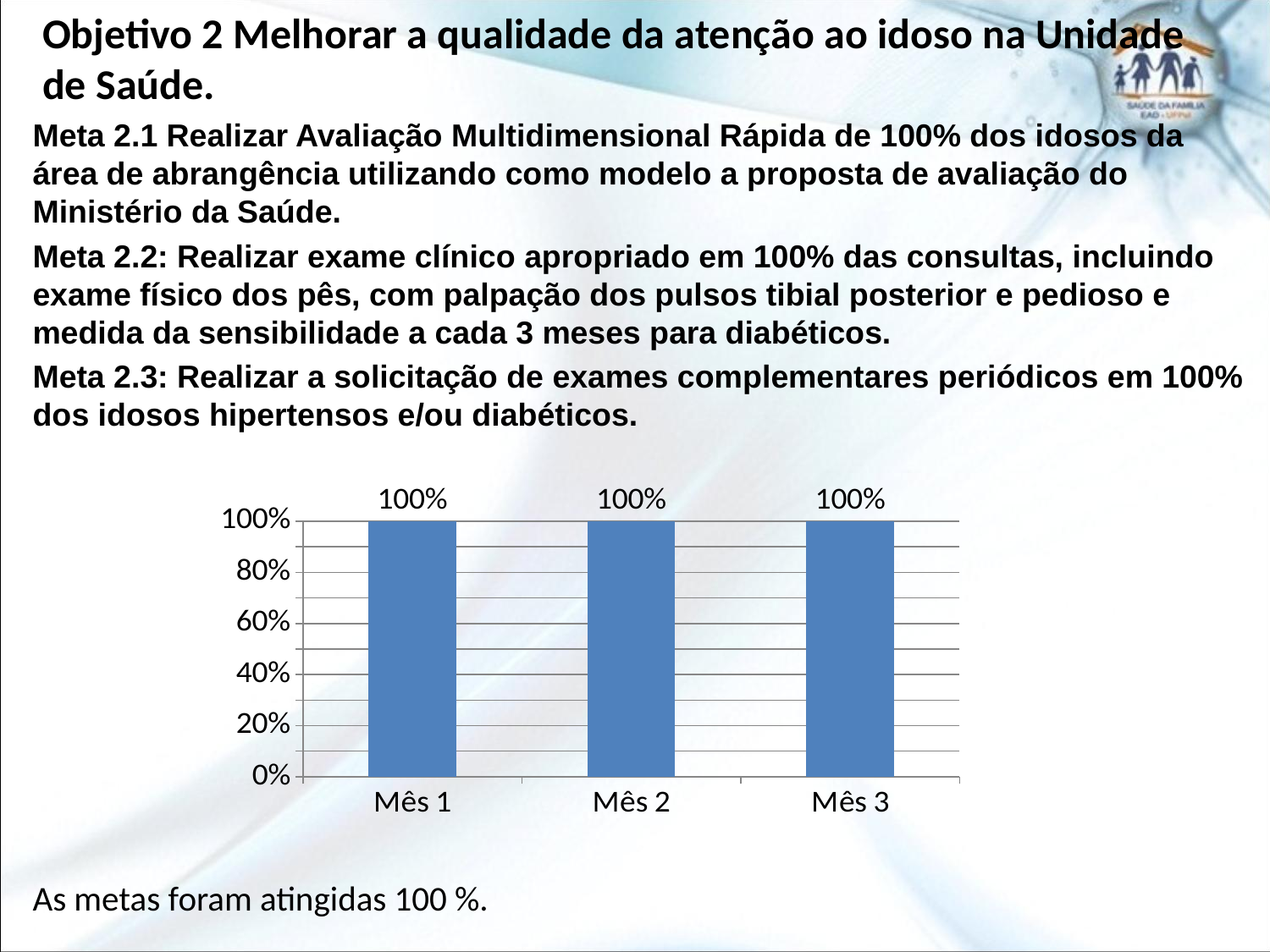
What is the value for Mês 3 in the bar chart? 100% Is the value for Mês 2 greater or less than 80%? greater What colour are the bars in the chart? Blue What is the highest tick label shown on the y axis of the chart? 100% What is the value for Mês 1 in the bar chart? 100% What is the value for Mês 2 in the bar chart? 100% Is the value for Mês 1 larger than, smaller than, or equal to the value for Mês 2? Equal Do the values rise, fall, or stay the same from Mês 1 to Mês 3? Stay the same How many categories are shown on the x axis of the bar chart? 3 What kind of chart is shown on the slide? Bar chart What is the difference between the values for Mês 1 and Mês 3? 0% What is the label of the first category on the x axis? Mês 1